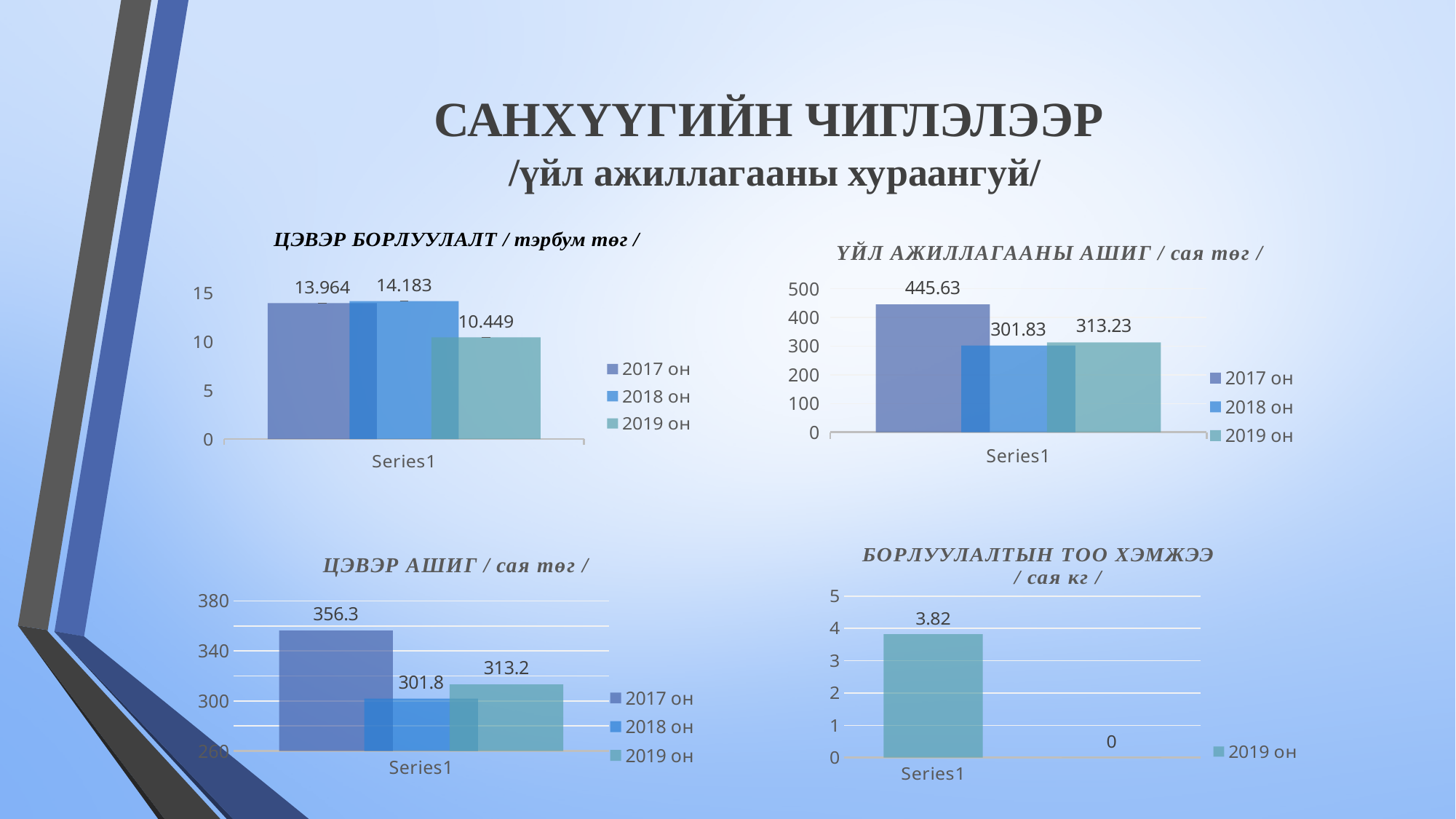
In the chart titled ҮЙЛ АЖИЛЛАГААНЫ АШИГ, which year has the highest value? 2017 он In the chart titled ЦЭВЭР БОРЛУУЛАЛТ, what is the difference between the 2018 он and 2019 он values? 3.734 What kind of chart is the chart titled ЦЭВЭР АШИГ? Bar chart In the chart titled ҮЙЛ АЖИЛЛАГААНЫ АШИГ, what is the value for 2017 он? 445.63 In the chart titled БОРЛУУЛАЛТЫН ТОО ХЭМЖЭЭ, what is the value for 2019 он? 3.82 In the chart titled ЦЭВЭР АШИГ, which is larger, the value for 2018 он or 2019 он? 2019 он In the chart titled ЦЭВЭР АШИГ, what is the value for 2019 он? 313.2 How many series does the legend of the chart titled БОРЛУУЛАЛТЫН ТОО ХЭМЖЭЭ list? 1 In the chart titled ЦЭВЭР БОРЛУУЛАЛТ, what is the value for 2018 он? 14.183 In the chart titled ЦЭВЭР БОРЛУУЛАЛТ, which year has the lowest value? 2019 он In the chart titled ҮЙЛ АЖИЛЛАГААНЫ АШИГ, what is the difference between the 2017 он and 2018 он values? 143.8 In the chart titled ЦЭВЭР АШИГ, what is the difference between the 2017 он and 2018 он values? 54.5